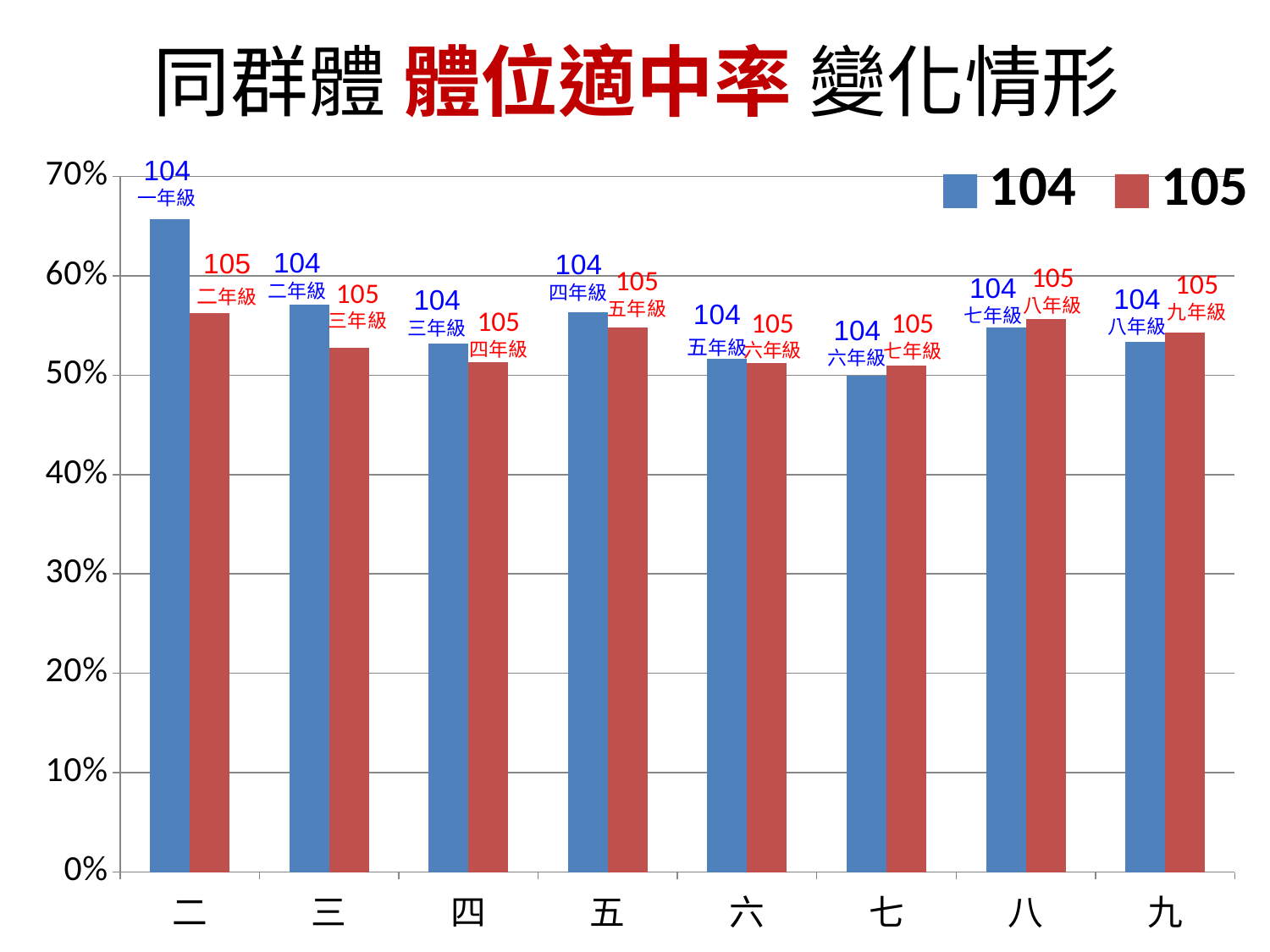
Is the 104 value for category 二 greater or less than 60%? greater What kind of chart is shown on the slide? bar chart For category 二, which series has the larger value, 104 or 105? 104 For category 三, which series has the larger value, 104 or 105? 104 Does the 104 series rise or fall from category 二 to category 四? fall How many categories are shown on the x axis? 8 Which category has the highest value for the 104 series? 二 Is the 104 value for category 三 greater or less than 60%? less How many series does the legend list? 2 What colour are the bars for the 105 series? red Is the 105 value for category 七 greater or less than 40%? greater